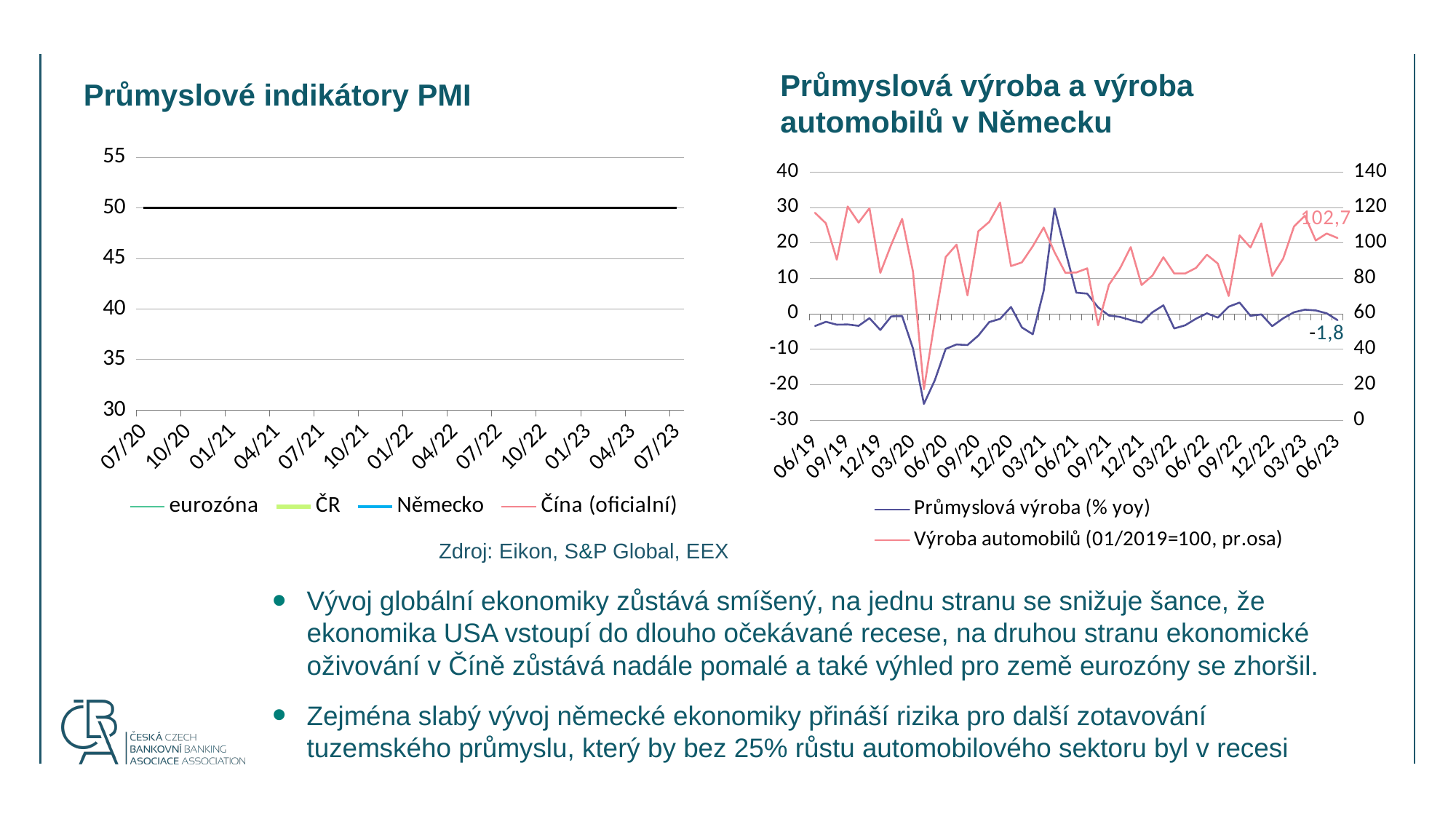
Which series are listed in the legend of the chart 'Průmyslové indikátory PMI'? eurozóna, ČR, Německo, Čína (oficialní) In the chart 'Průmyslová výroba a výroba automobilů v Německu', is the highest value of Průmyslová výroba (% yoy) greater or less than 20? greater How many series does the legend of the chart 'Průmyslová výroba a výroba automobilů v Německu' list? 2 In the chart 'Průmyslová výroba a výroba automobilů v Německu', what is the last labelled value of Výroba automobilů (01/2019=100, pr.osa)? 102,7 In the chart 'Průmyslová výroba a výroba automobilů v Německu', is the value of Výroba automobilů at 06/23 greater or less than 100? greater In the chart 'Průmyslové indikátory PMI', at what level is the horizontal black reference line drawn? 50 What kind of chart is 'Průmyslová výroba a výroba automobilů v Německu'? line chart How many series does the legend of the chart 'Průmyslové indikátory PMI' list? 4 In the chart 'Průmyslová výroba a výroba automobilů v Německu', does Výroba automobilů rise or fall between 12/22 and 03/23? rise In the chart 'Průmyslová výroba a výroba automobilů v Německu', is the lowest value of Průmyslová výroba (% yoy) greater or less than -20? less In the chart 'Průmyslová výroba a výroba automobilů v Německu', what is the last labelled value of Průmyslová výroba (% yoy)? -1,8